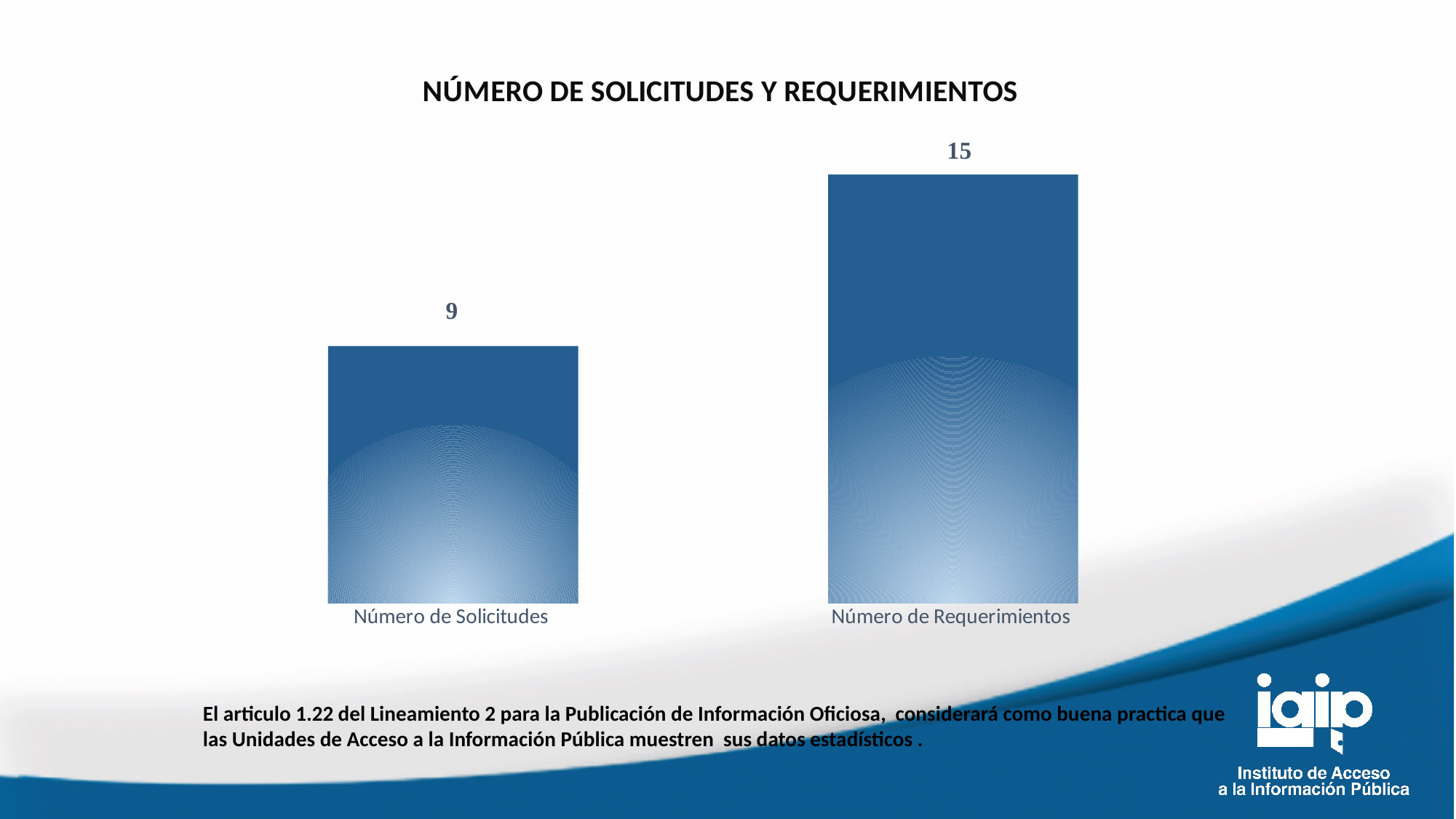
What is the title of the chart? NÚMERO DE SOLICITUDES Y REQUERIMIENTOS How many categories are shown in the chart? 2 What is the difference between Número de Requerimientos and Número de Solicitudes? 6 What is the total of the two values shown in the chart? 24 Which category has the highest value? Número de Requerimientos Which is larger, Número de Solicitudes or Número de Requerimientos? Número de Requerimientos What is the value for Número de Solicitudes? 9 What kind of chart is shown on the slide? Bar chart What is the value for Número de Requerimientos? 15 Which category has the lowest value? Número de Solicitudes